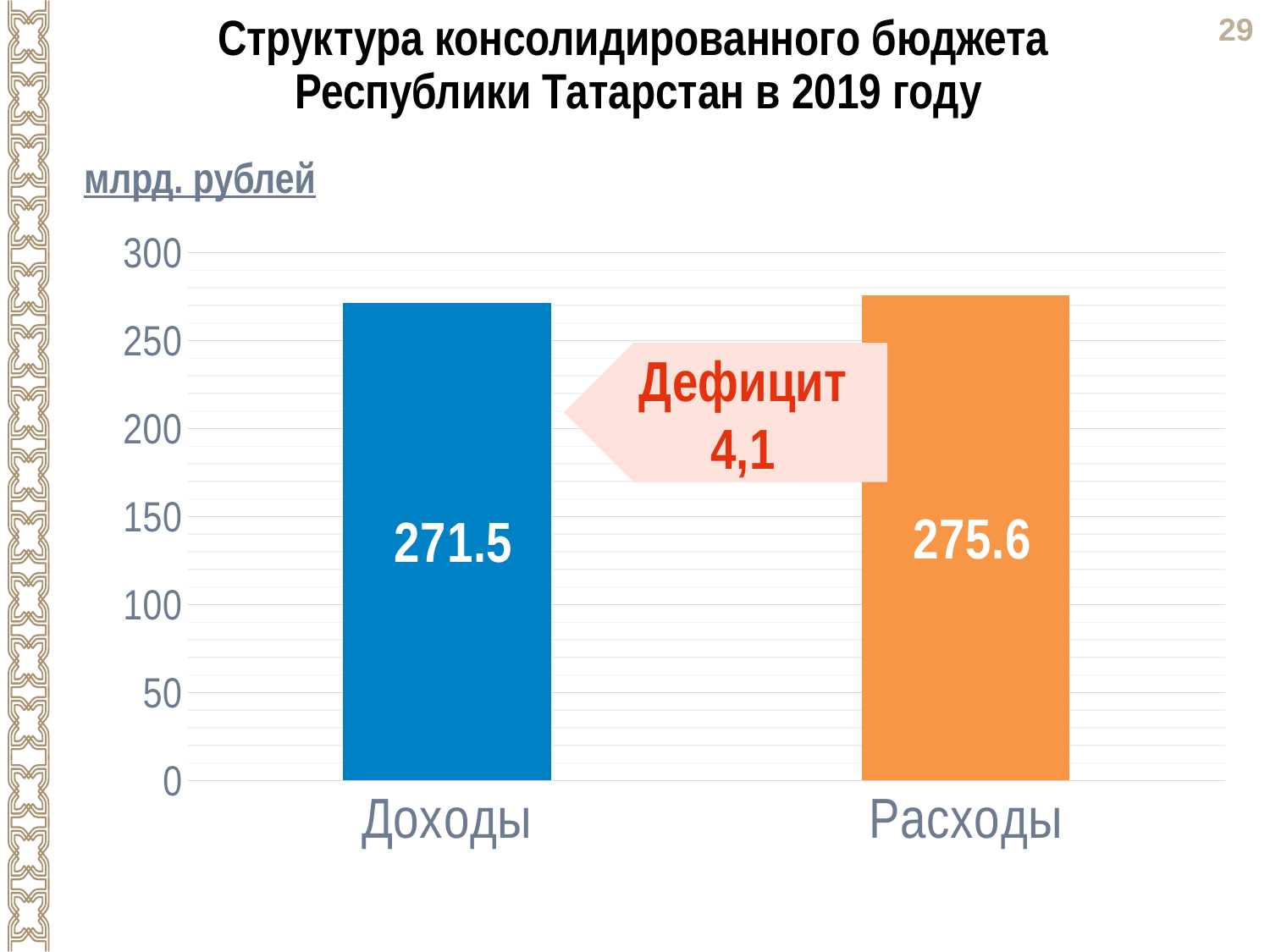
Which category has the higher value, Доходы or Расходы? Расходы What unit is stated above the chart? млрд. рублей Is the value for Доходы greater or less than 250? greater What kind of chart is shown on the slide? bar chart What is the value for Расходы? 275.6 What is the value for Доходы? 271.5 What deficit value is shown in the arrow label between the bars? 4,1 Which category has the highest value? Расходы How many categories are shown on the x axis? 2 Which category has the lowest value? Доходы Is the value for Расходы greater or less than 300? less What is the difference between the values for Расходы and Доходы? 4.1